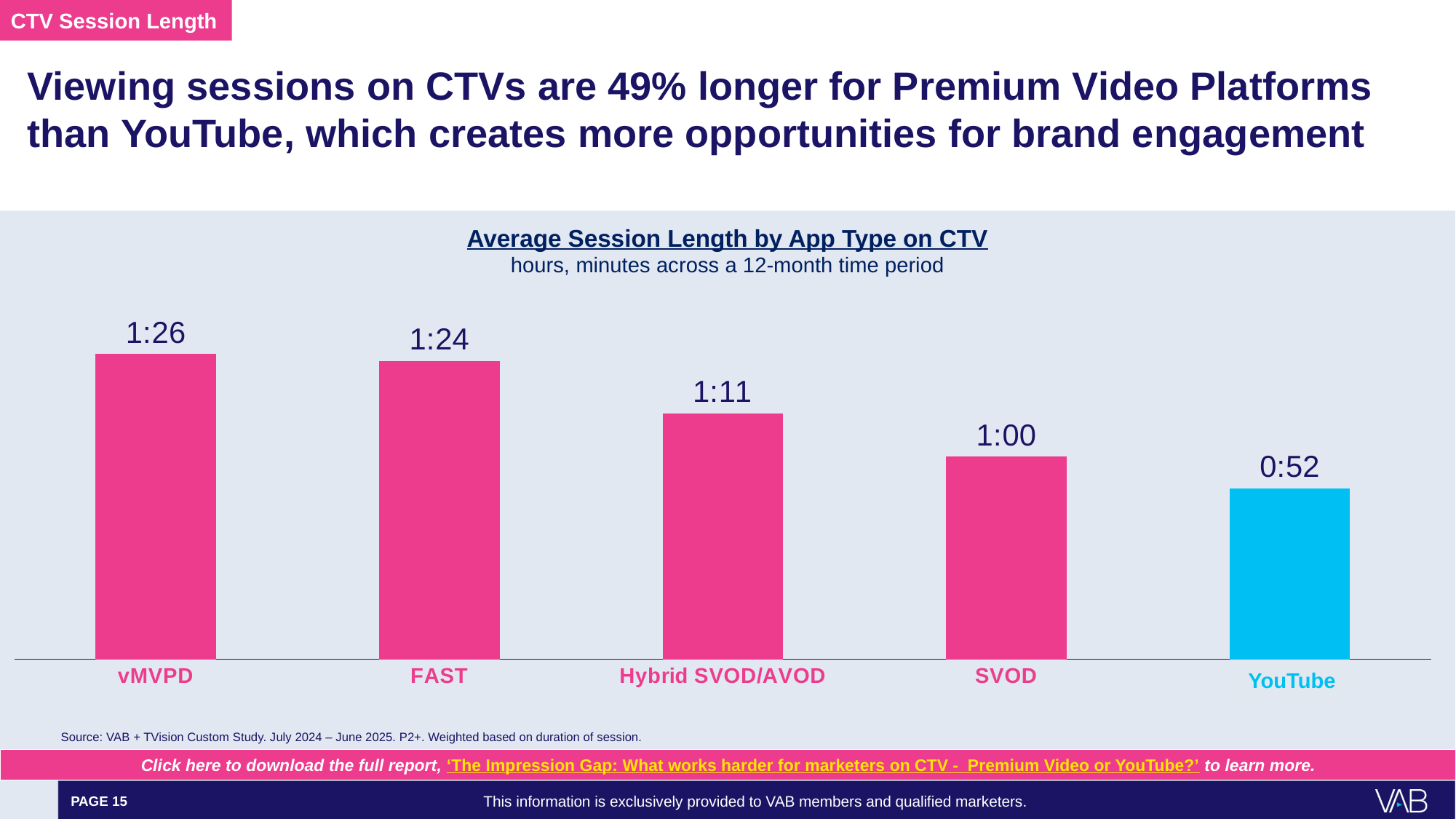
Which has a longer average session length, Hybrid SVOD/AVOD or SVOD? Hybrid SVOD/AVOD Which app type has the shortest average session length? YouTube How many app types are shown in the chart? 5 What is the average session length for YouTube? 0:52 What is the average session length for SVOD? 1:00 How many minutes longer is the average session length for FAST than for SVOD? 24 minutes Which app type has the longest average session length? vMVPD Which bar is shown in a different colour (blue) from the others? YouTube What type of chart is shown on the slide? Bar chart What is the average session length for vMVPD? 1:26 How many minutes longer is the average session length for vMVPD than for YouTube? 34 minutes What is the average session length for Hybrid SVOD/AVOD? 1:11